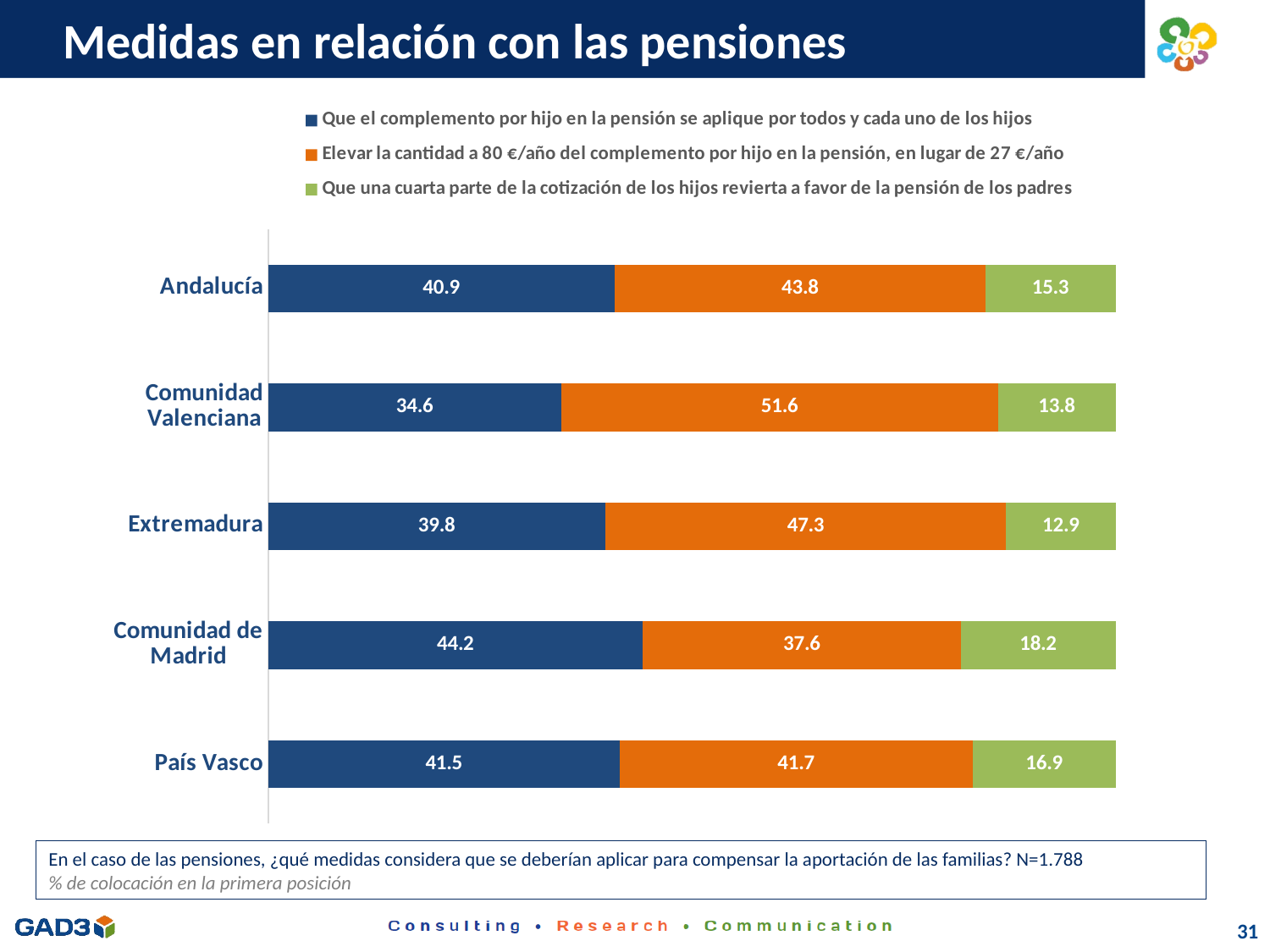
How many series does the legend list? 3 What is the difference between the 'Elevar la cantidad a 80 €/año' values for Comunidad Valenciana and Comunidad de Madrid? 14.0 What kind of chart is shown on the slide? Stacked bar chart Which region has the lowest value in the series 'Que una cuarta parte de la cotización de los hijos revierta a favor de la pensión de los padres'? Extremadura What is the value for Extremadura in the series 'Que el complemento por hijo en la pensión se aplique por todos y cada uno de los hijos'? 39.8 How many regions are shown in the chart? 5 Which region has the lowest value in the series 'Que el complemento por hijo en la pensión se aplique por todos y cada uno de los hijos'? Comunidad Valenciana What is the value for Andalucía in the series 'Elevar la cantidad a 80 €/año del complemento por hijo en la pensión, en lugar de 27 €/año'? 43.8 Which is larger for País Vasco: the value for 'Que el complemento por hijo en la pensión se aplique por todos y cada uno de los hijos' or the value for 'Que una cuarta parte de la cotización de los hijos revierta a favor de la pensión de los padres'? Que el complemento por hijo en la pensión se aplique por todos y cada uno de los hijos What is the total of the stacked bar for Comunidad de Madrid? 100.0 Which region has the highest value in the series 'Elevar la cantidad a 80 €/año del complemento por hijo en la pensión, en lugar de 27 €/año'? Comunidad Valenciana What is the value for Comunidad de Madrid in the series 'Que una cuarta parte de la cotización de los hijos revierta a favor de la pensión de los padres'? 18.2